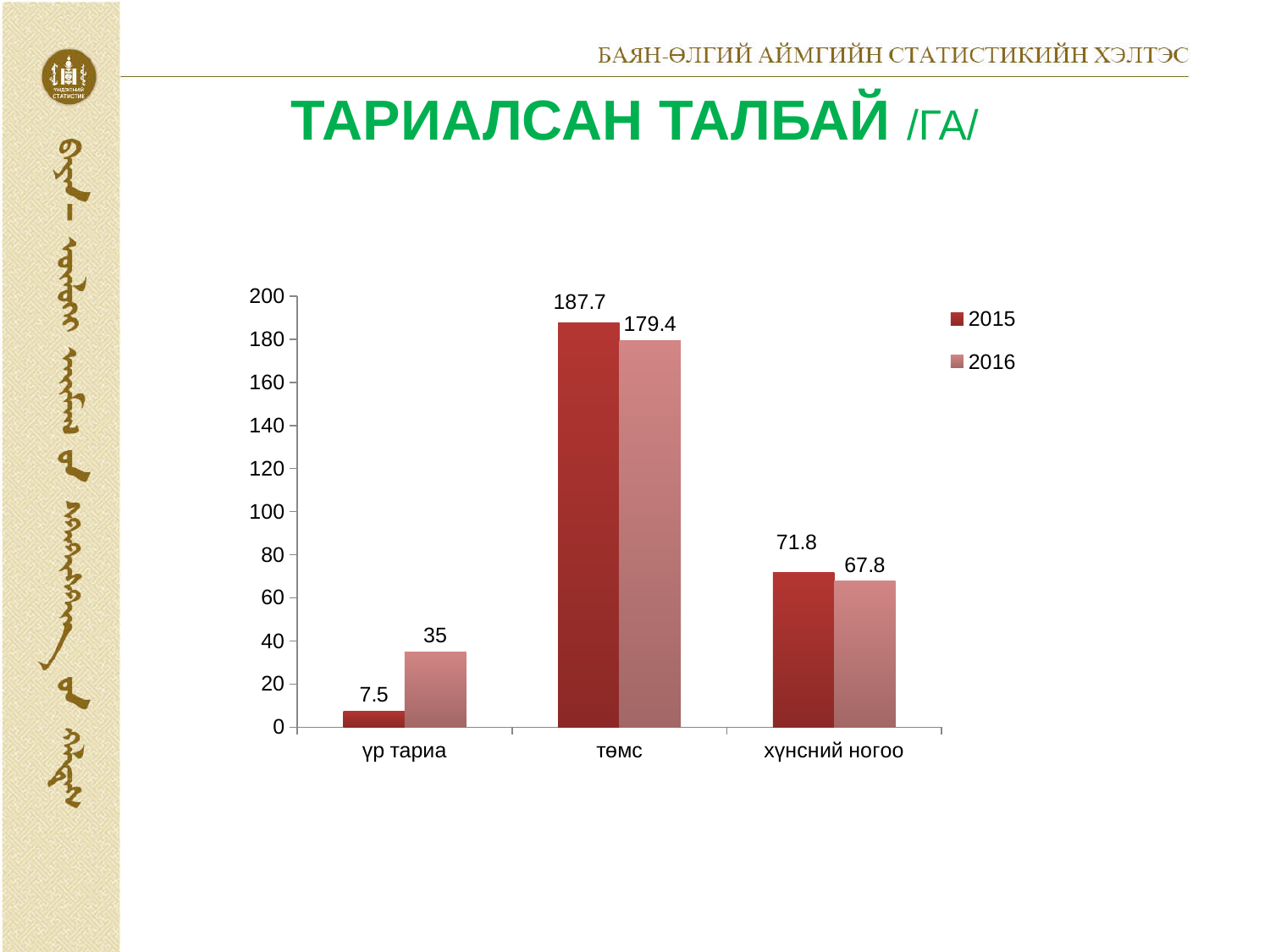
Which category has the highest value in 2015? төмс What is the value for төмс in 2015? 187.7 What kind of chart is shown on the slide? bar chart What is the value for үр тариа in 2016? 35 What is the difference between the 2016 and 2015 values for үр тариа? 27.5 What is the value for хүнсний ногоо in 2016? 67.8 What is the difference between the 2015 and 2016 values for төмс? 8.3 Which category has the lowest value in 2016? үр тариа How many series does the legend list? 2 What is the title of the slide? ТАРИАЛСАН ТАЛБАЙ /ГА/ Which is larger for хүнсний ногоо, the 2015 value or the 2016 value? 2015 How many categories are shown on the x axis? 3